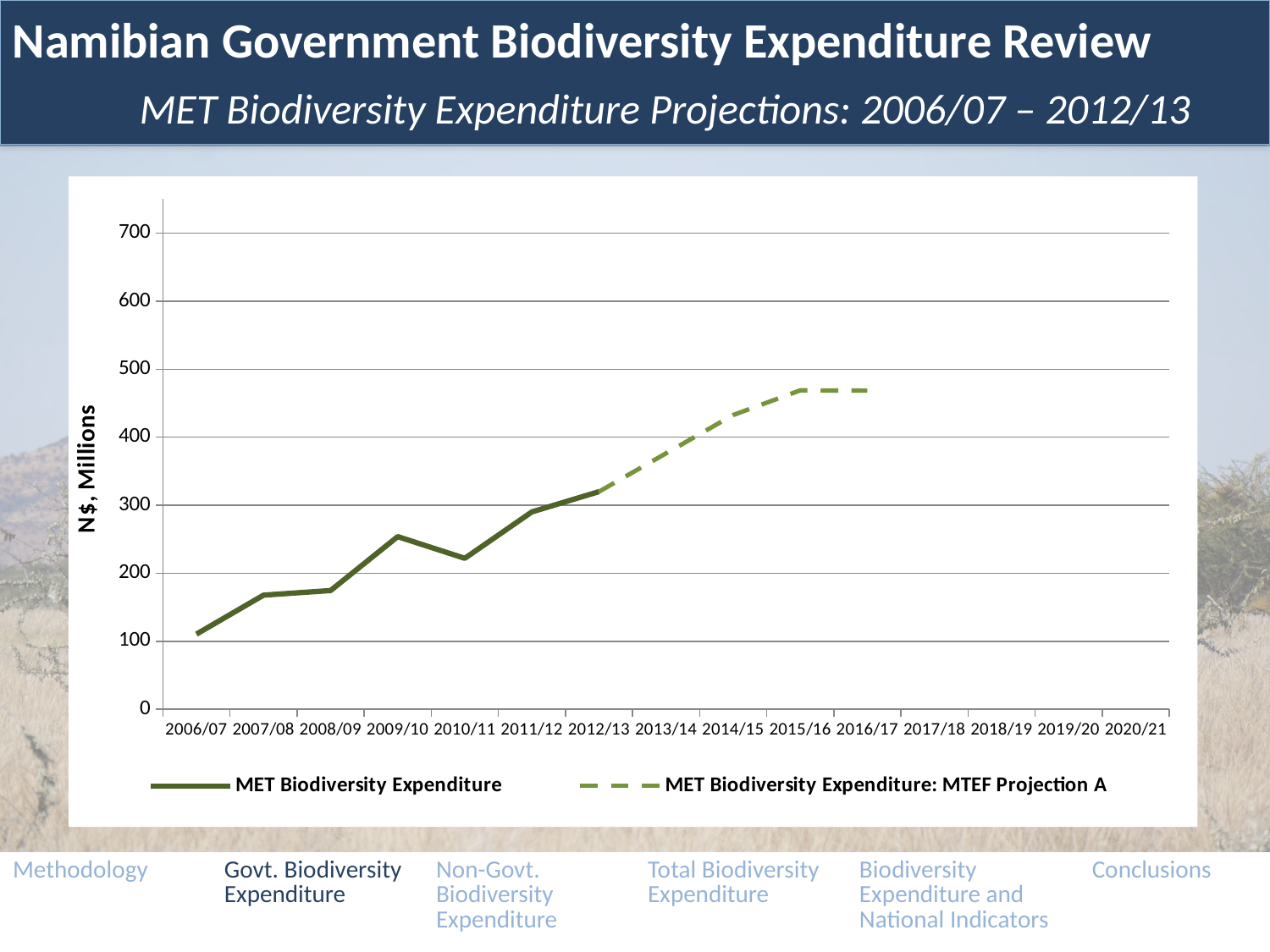
Is the MET Biodiversity Expenditure value for 2006/07 greater or less than 200? less What is the label on the vertical axis? N$, Millions What kind of chart is shown on the slide? line chart Is the MTEF Projection A value for 2016/17 greater or less than 500? less Which series is drawn with a dashed line? MET Biodiversity Expenditure: MTEF Projection A Is the MTEF Projection A value for 2015/16 greater or less than 400? greater Overall, does MET Biodiversity Expenditure rise or fall from 2006/07 to 2012/13? rise Which is larger for MET Biodiversity Expenditure, the value for 2009/10 or the value for 2010/11? 2009/10 How many series does the legend list? 2 How many fiscal-year categories are shown on the x axis? 15